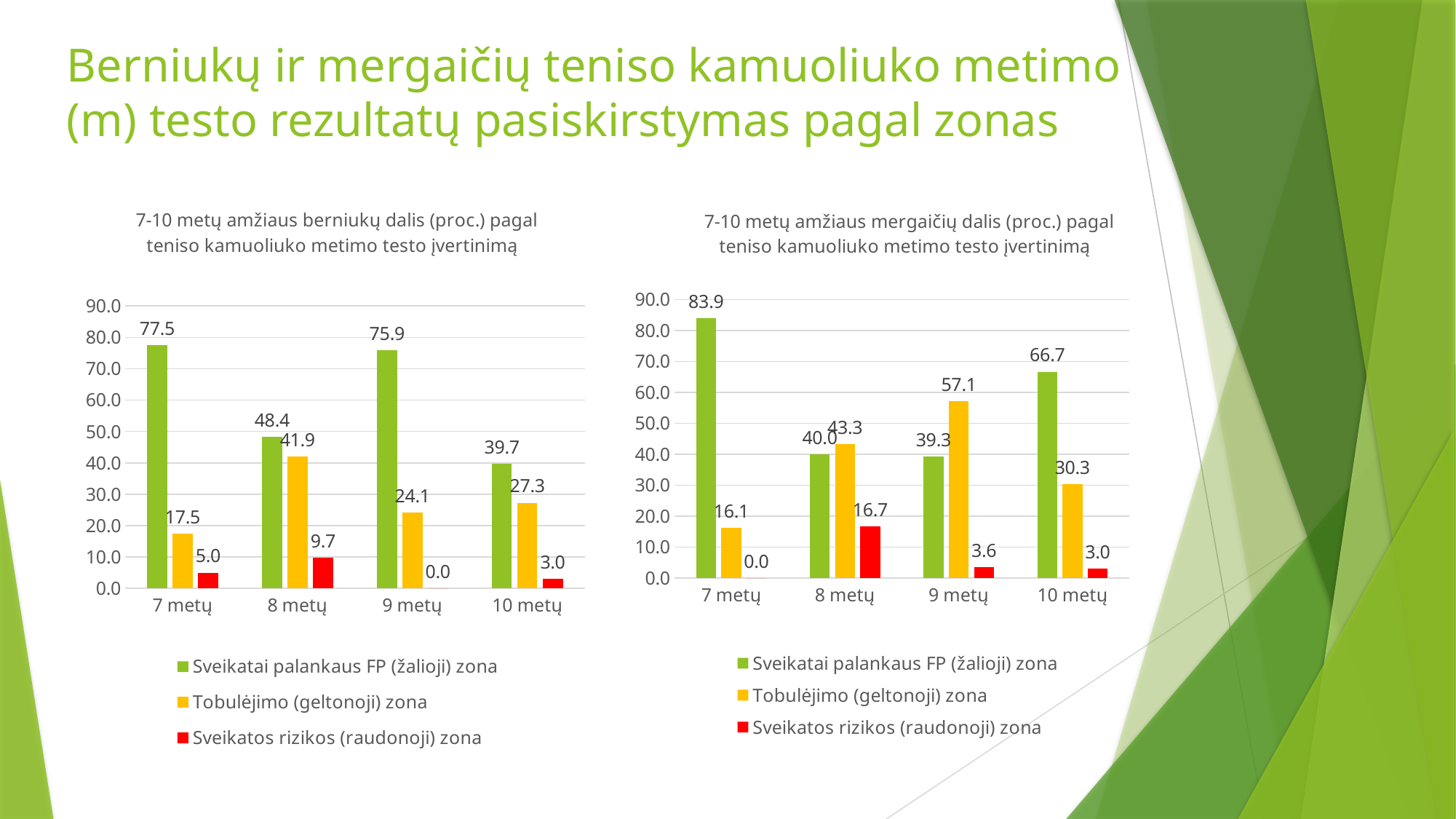
In the left chart (boys), which age group has the lowest value for Sveikatos rizikos (raudonoji) zona? 9 metų In the left chart (boys), what is the difference between the Sveikatai palankaus FP (žalioji) zona and Tobulėjimo (geltonoji) zona values at 8 metų? 6.5 In the right chart (girls), at 8 metų, which is larger: Sveikatai palankaus FP (žalioji) zona or Tobulėjimo (geltonoji) zona? Tobulėjimo (geltonoji) zona In the right chart (girls), what is the value for Sveikatos rizikos (raudonoji) zona at 8 metų? 16.7 How many series does the legend of the right chart (girls) list? 3 In the left chart (boys), which age group has the highest value for Sveikatai palankaus FP (žalioji) zona? 7 metų In the left chart (boys), what is the total of the three zone values at 10 metų? 70.0 In the right chart (girls), what is the difference between the Sveikatai palankaus FP (žalioji) zona values at 7 metų and 10 metų? 17.2 In the right chart (girls), what is the value for Tobulėjimo (geltonoji) zona at 9 metų? 57.1 What type of chart is the left chart (boys)? Bar chart In the left chart (boys), what is the value for Sveikatai palankaus FP (žalioji) zona at 7 metų? 77.5 How many age groups are shown on the x axis of the left chart (boys)? 4